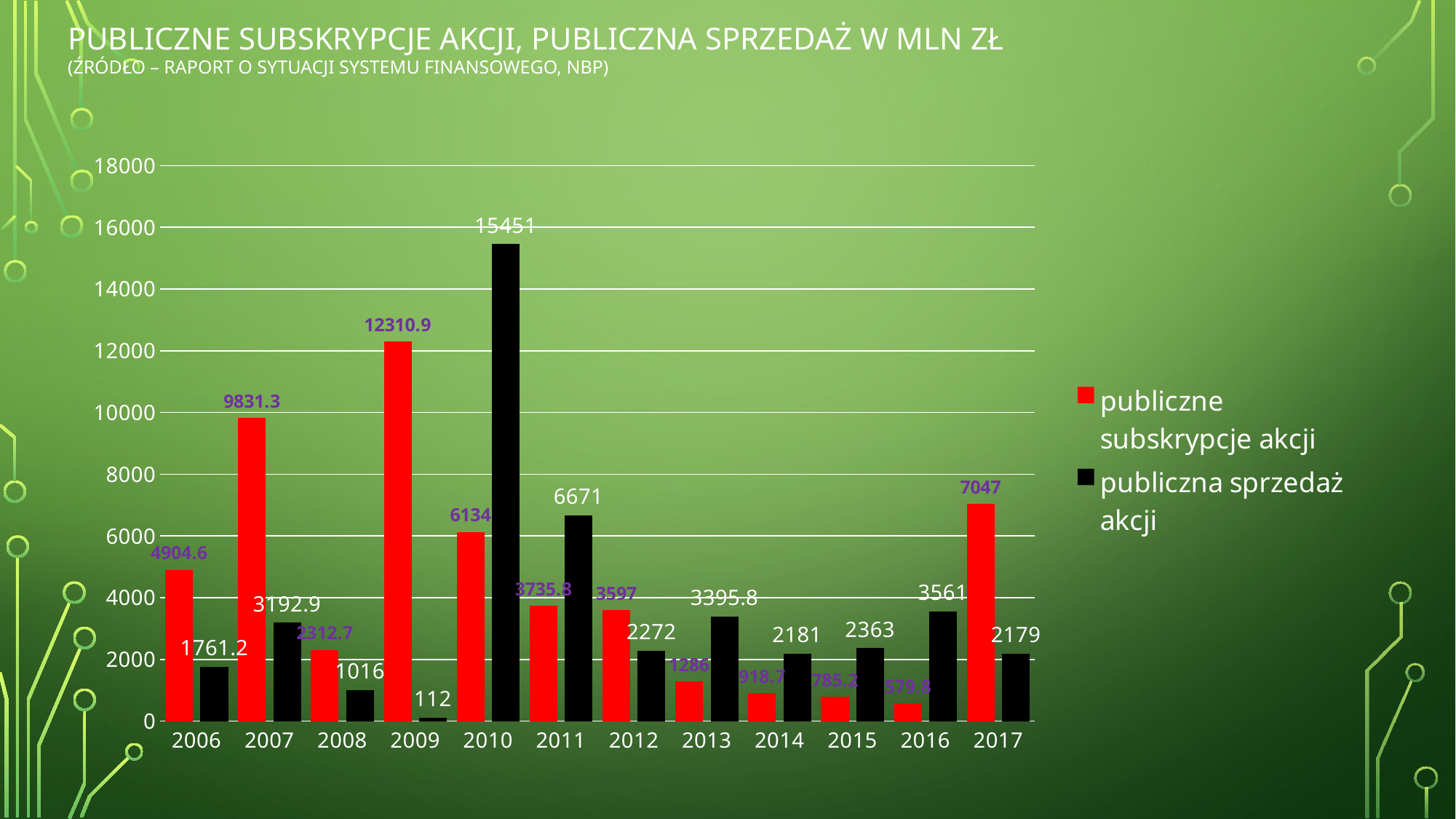
In which year is publiczna sprzedaż akcji the lowest? 2009 What is the value of publiczne subskrypcje akcji in 2009? 12310.9 What type of chart is shown on the slide? bar chart Which colour represents publiczna sprzedaż akcji in the chart? black What is the value of publiczna sprzedaż akcji in 2009? 112 What is the value of publiczna sprzedaż akcji in 2010? 15451 How many years are shown on the x axis? 12 How many series does the legend list? 2 In which year is publiczne subskrypcje akcji the highest? 2009 In which year is publiczne subskrypcje akcji the lowest? 2016 Which is larger in 2017: publiczne subskrypcje akcji or publiczna sprzedaż akcji? publiczne subskrypcje akcji What is the difference between publiczna sprzedaż akcji and publiczne subskrypcje akcji in 2010? 9317